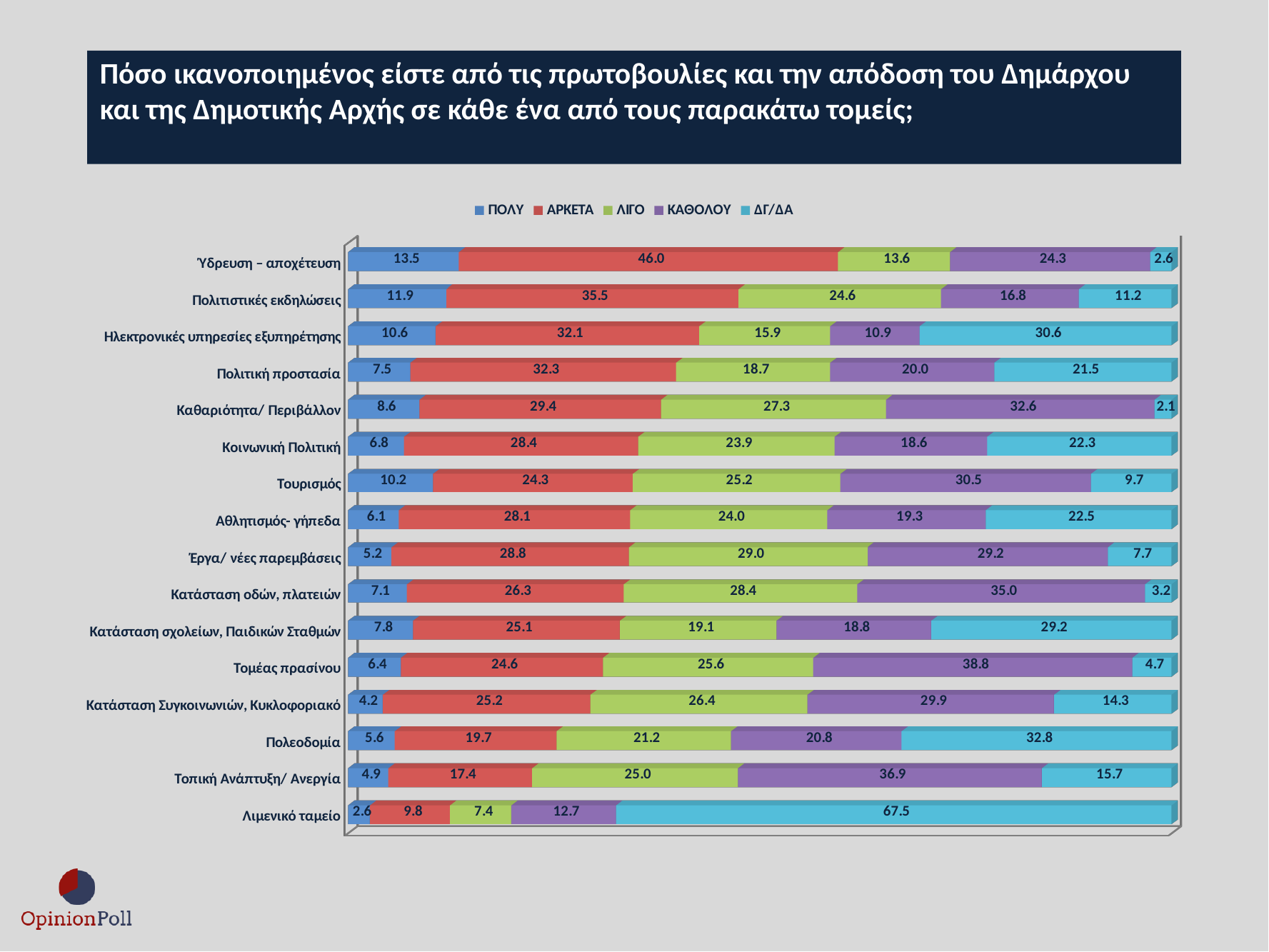
What is the ΛΙΓΟ value for Καθαριότητα/ Περιβάλλον? 27.3 Which has the larger ΑΡΚΕΤΑ value: Πολιτιστικές εκδηλώσεις or Ηλεκτρονικές υπηρεσίες εξυπηρέτησης? Πολιτιστικές εκδηλώσεις What is the ΑΡΚΕΤΑ value for Ύδρευση – αποχέτευση? 46.0 What is the total of the stacked bar for Ύδρευση – αποχέτευση? 100.0 What is the ΔΓ/ΔΑ value for Λιμενικό ταμείο? 67.5 What is the difference between the ΚΑΘΟΛΟΥ and ΠΟΛΥ values for Τομέας πρασίνου? 32.4 Which category has the lowest ΠΟΛΥ value? Λιμενικό ταμείο Which category has the highest ΠΟΛΥ value? Ύδρευση – αποχέτευση Which category has the highest ΚΑΘΟΛΟΥ value? Τομέας πρασίνου How many categories are shown in the chart? 16 What kind of chart is shown on the slide? Stacked bar chart How many series does the legend list? 5